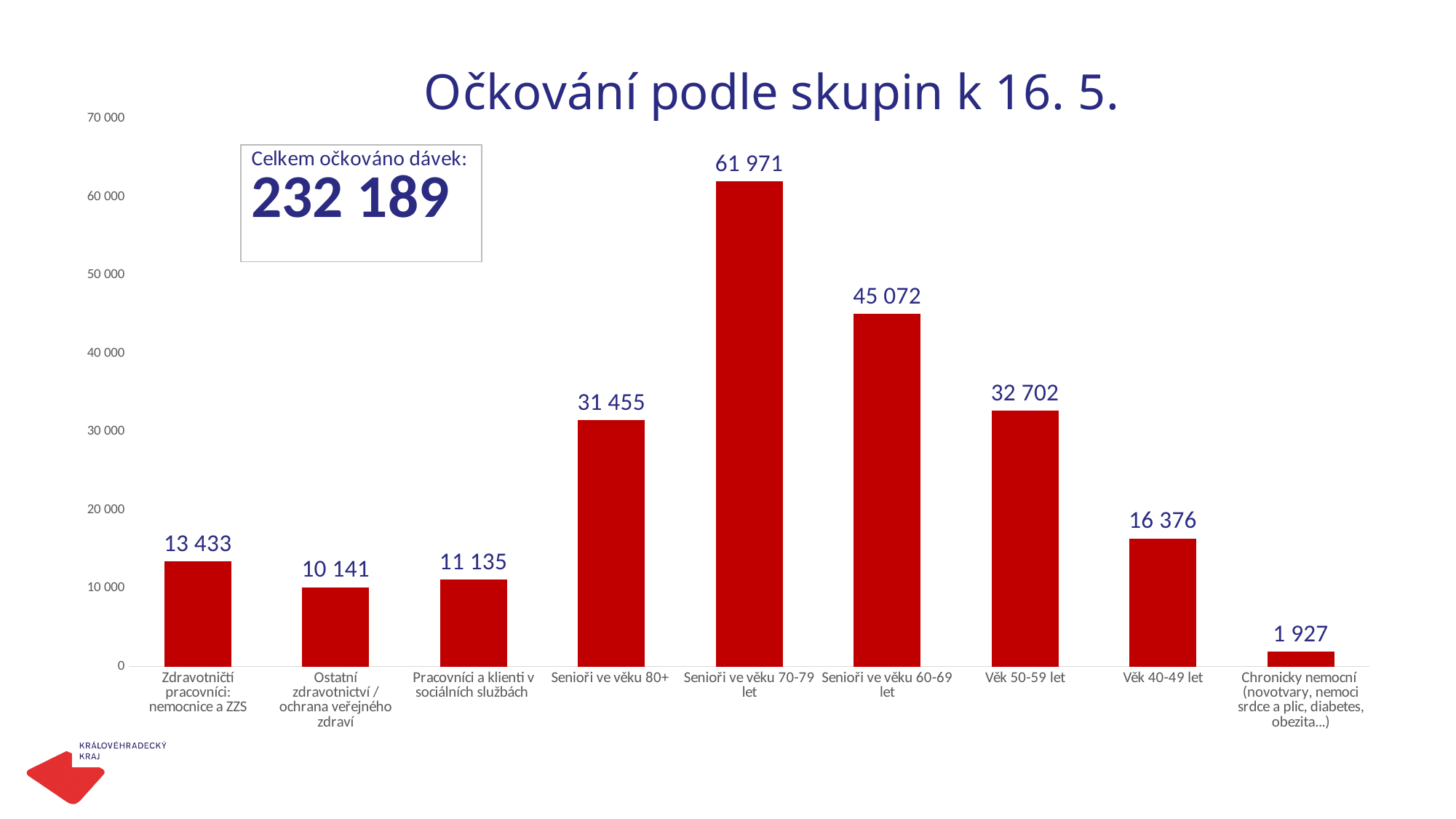
Which category has the highest value? Senioři ve věku 70-79 let Is the value for Senioři ve věku 60-69 let greater or less than 40 000? greater What is the difference between the values for Zdravotničtí pracovníci: nemocnice a ZZS and Ostatní zdravotnictví / ochrana veřejného zdraví? 3 292 What is the difference between the values for Senioři ve věku 70-79 let and Senioři ve věku 60-69 let? 16 899 What is the value for Pracovníci a klienti v sociálních službách? 11 135 What is the value for Věk 40-49 let? 16 376 What is the value for Senioři ve věku 70-79 let? 61 971 Which category has the lowest value? Chronicky nemocní (novotvary, nemoci srdce a plic, diabetes, obezita…) How many categories are shown in the chart? 9 Which is larger, the value for Věk 50-59 let or the value for Senioři ve věku 80+? Věk 50-59 let What kind of chart is shown on the slide? bar chart What is the title of the chart? Očkování podle skupin k 16. 5.